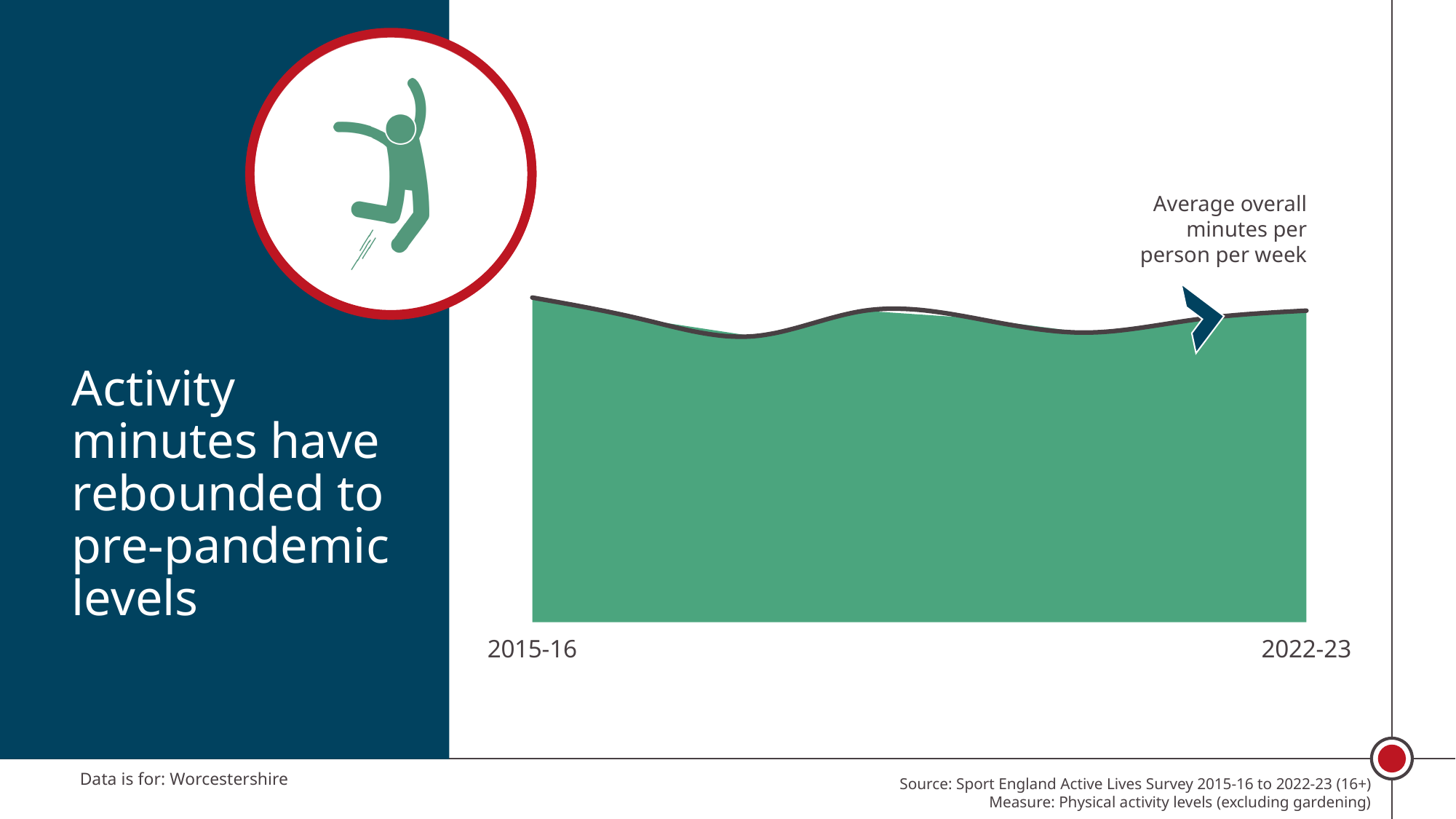
From 2015-16 to the first dip in the line, do the values rise or fall? Fall What is the first period labelled on the x axis of the chart? 2015-16 What kind of chart is shown on the slide? Area chart What is the last period labelled on the x axis of the chart? 2022-23 Is the value at 2022-23 higher or lower than the lowest point on the line? Higher Is the value at 2015-16 higher or lower than the lowest point on the line? Higher From the lowest point of the line to 2022-23, do the values rise or fall? Rise